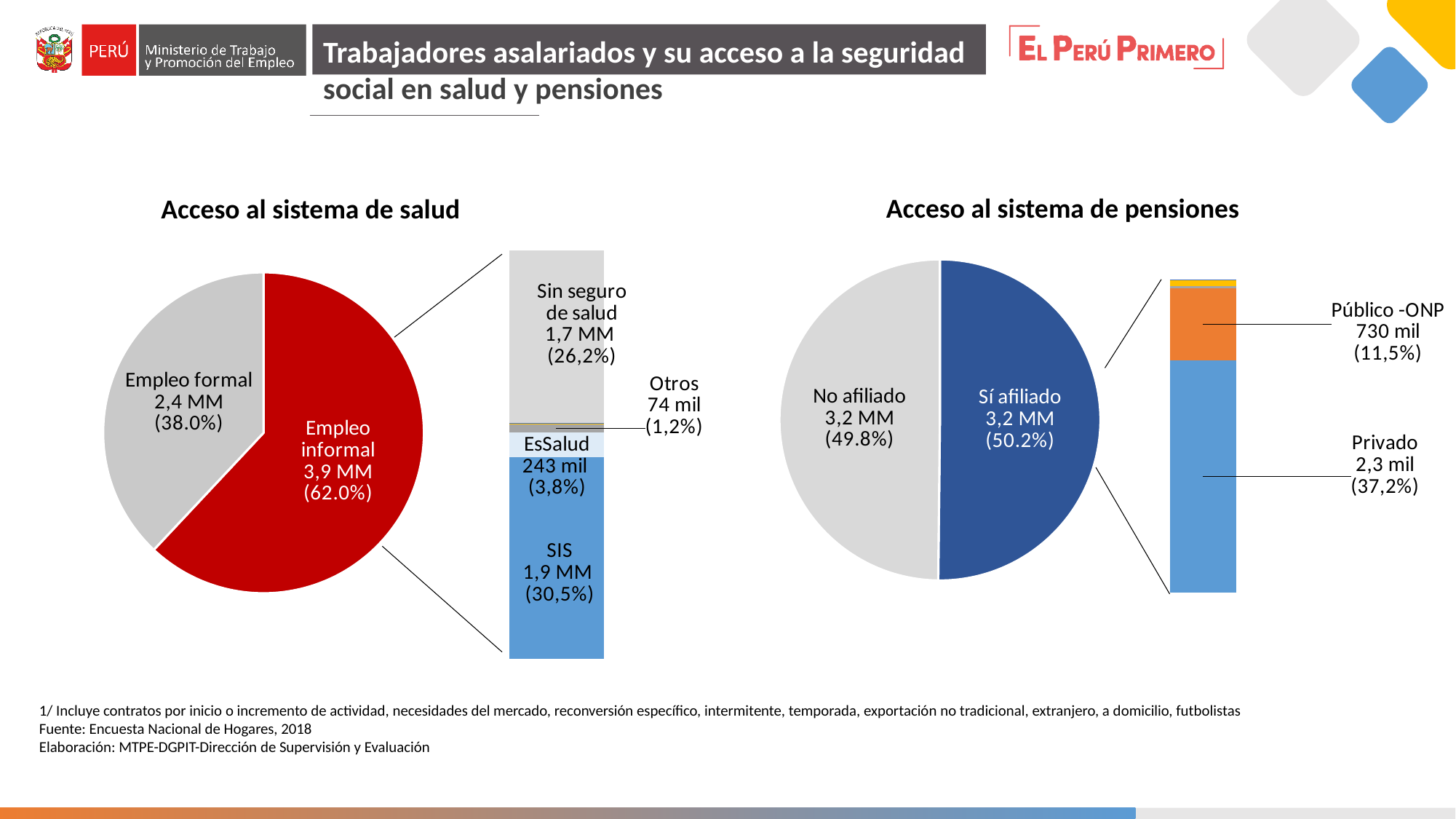
In the 'Acceso al sistema de salud' chart, which segment of the breakdown bar is the smallest? Otros In the 'Acceso al sistema de salud' chart, what value is shown for 'Empleo formal'? 2,4 MM In the 'Acceso al sistema de salud' chart, what is the difference in percentage points between 'Empleo informal' and 'Empleo formal'? 24.0 percentage points In the 'Acceso al sistema de salud' chart, what value is shown for 'Otros'? 74 mil In the 'Acceso al sistema de salud' chart, what percentage is labelled for 'SIS' in the breakdown bar? 30,5% In the 'Acceso al sistema de pensiones' chart, what value is shown for 'Público -ONP'? 730 mil In the 'Acceso al sistema de salud' chart, what value is shown for 'EsSalud'? 243 mil In the 'Acceso al sistema de pensiones' chart, what percentage of the pie is 'Sí afiliado'? 50.2% In the 'Acceso al sistema de salud' chart, which pie slice is larger, 'Empleo formal' or 'Empleo informal'? Empleo informal What type of chart is used for 'Acceso al sistema de pensiones'? Pie chart In the 'Acceso al sistema de salud' chart, which segment of the breakdown bar is the largest? SIS In the 'Acceso al sistema de salud' chart, what percentage of the pie is 'Empleo informal'? 62.0%